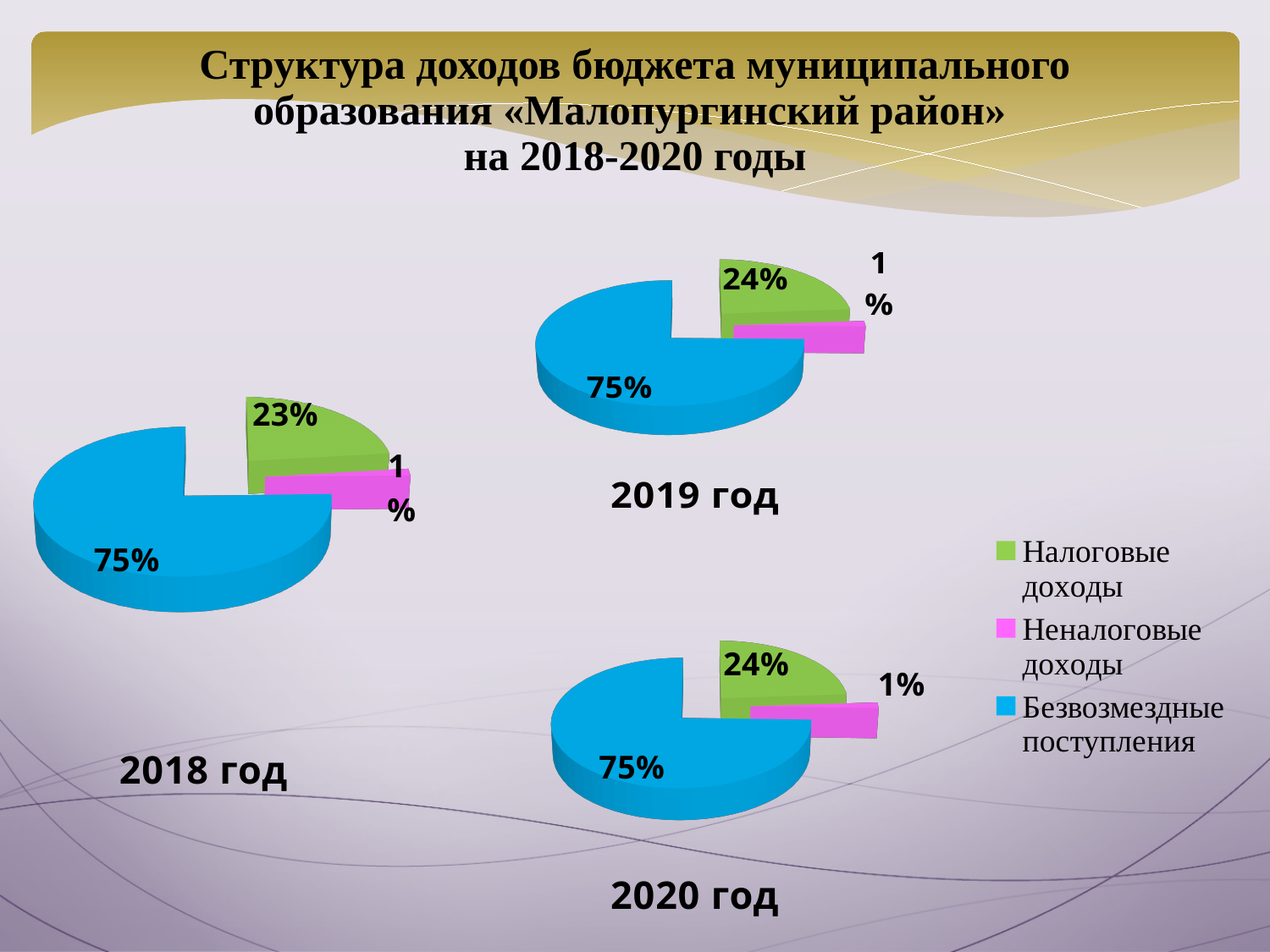
How many slices does the 2019 год chart have? 3 In the 2018 год chart, which category has the largest slice? Безвозмездные поступления What kind of chart is the 2018 год chart? Pie chart In the 2020 год chart, which is larger: Налоговые доходы or Неналоговые доходы? Налоговые доходы In the 2020 год chart, what share is labelled for Безвозмездные поступления? 75% In the 2019 год chart, what share is labelled for Налоговые доходы? 24% In the 2020 год chart, what share is labelled for Неналоговые доходы? 1% In the 2018 год chart, what share is labelled for Налоговые доходы? 23% In the 2018 год chart, what is the difference between the shares of Безвозмездные поступления and Налоговые доходы? 52% In the 2019 год chart, which category has the smallest slice? Неналоговые доходы Which colour represents Безвозмездные поступления in the legend? Blue How many entries does the legend list? 3